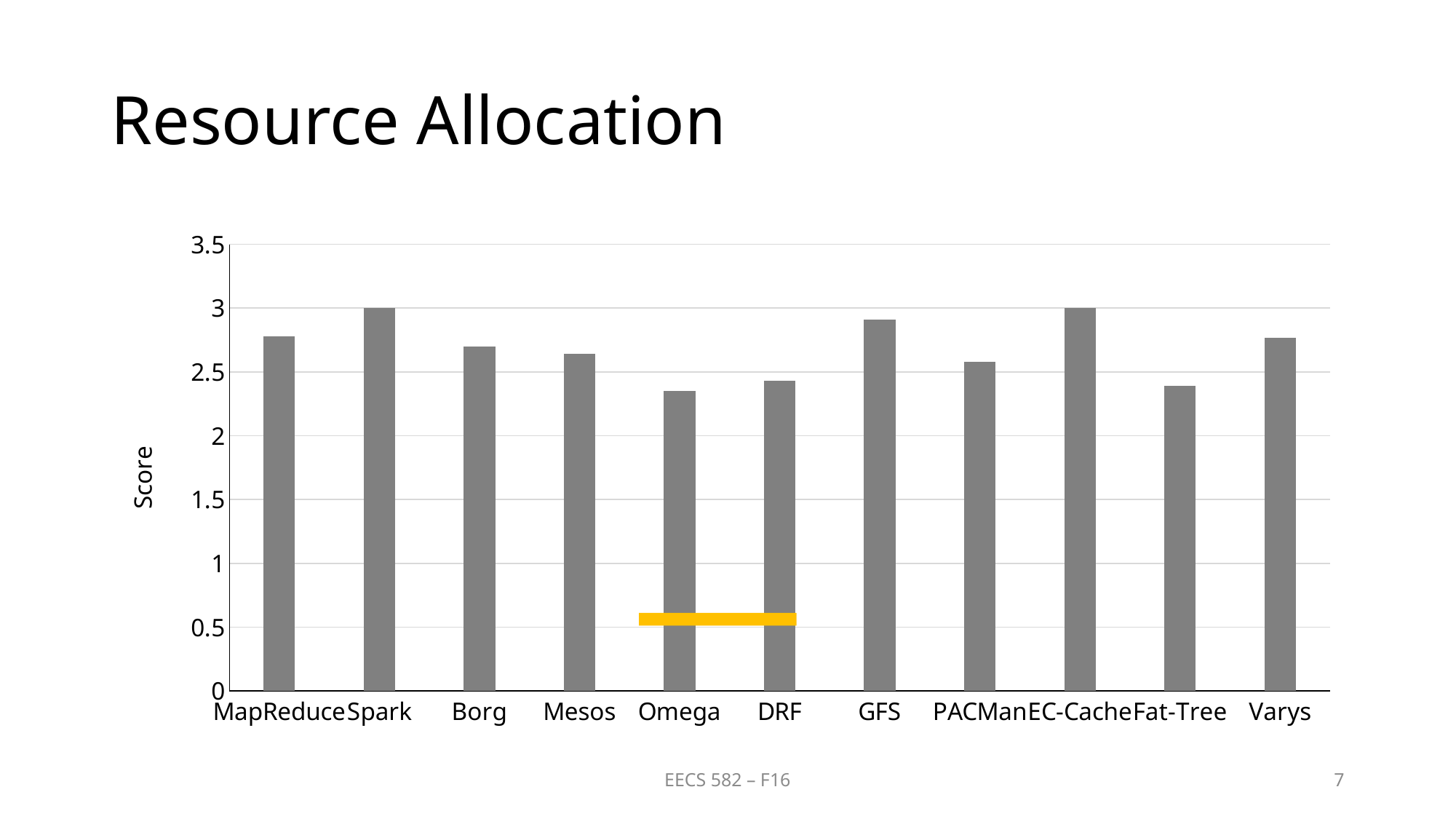
What is the score for Spark? 3 Is the value for Fat-Tree greater or less than 2.5? less Is the value for Omega greater or less than 2.5? less Which has the higher score, Spark or Omega? Spark How many categories are shown on the x axis of the chart? 11 What is the score for EC-Cache? 3 Is the value for MapReduce greater or less than 2.5? greater Which has the higher score, GFS or Mesos? GFS What is the title of the slide containing the chart? Resource Allocation What is the label of the vertical axis? Score What kind of chart is shown on the slide? bar chart